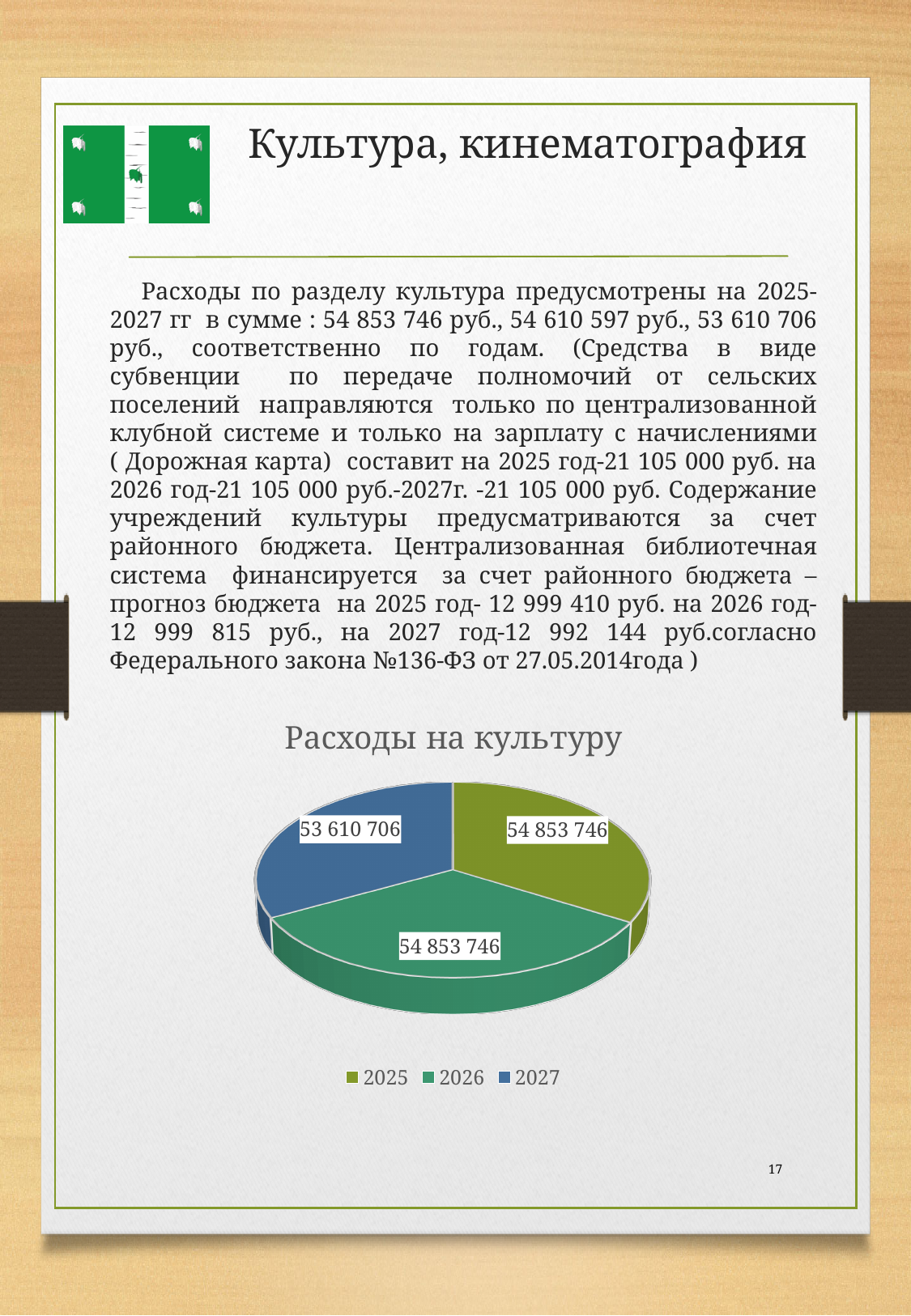
What value is labelled on the 2026 slice of the pie chart? 54 853 746 Which year has the smallest slice in the pie chart? 2027 How many slices does the pie chart have? 3 What is the title of the chart? Расходы на культуру What colour is the slice for 2027 in the pie chart? blue What value is shown for 2025 in the pie chart? 54 853 746 Which is larger, the value for 2025 or the value for 2027? 2025 What is the difference between the value for 2025 and the value for 2027? 1 243 040 What value is shown for 2027 in the pie chart? 53 610 706 How many entries does the legend list? 3 What kind of chart is shown on the slide? pie chart